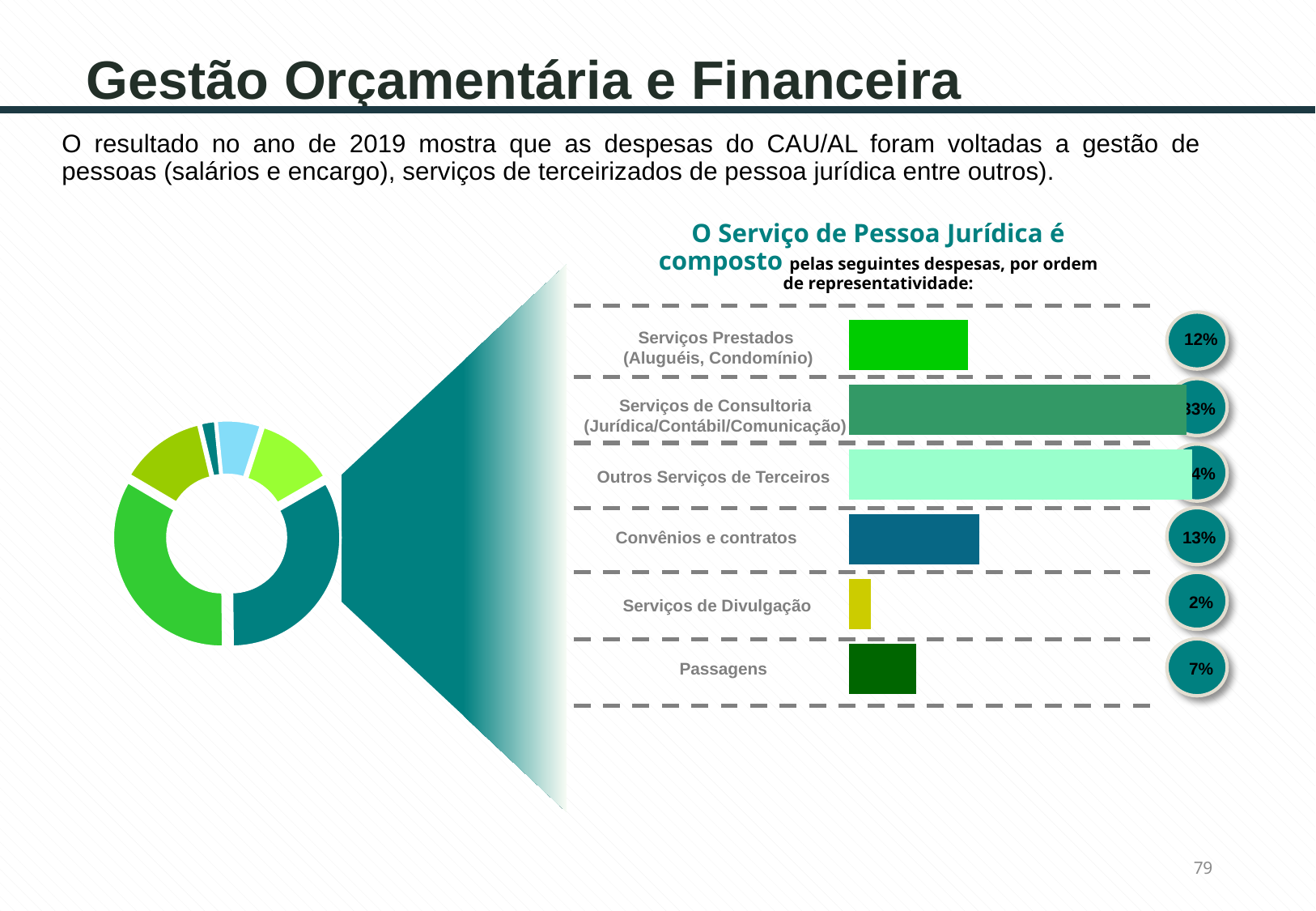
In the bar chart on the right, what percentage is shown for Serviços de Divulgação? 2% How many categories are shown in the bar chart on the right? 6 In the bar chart on the right, which is larger: Passagens or Serviços de Divulgação? Passagens In the bar chart on the right, which category has the lowest percentage? Serviços de Divulgação What kind of chart is the chart on the right of the slide? Bar chart In the bar chart on the right, what percentage is shown for Convênios e contratos? 13% In the bar chart on the right, what percentage is shown for Serviços Prestados (Aluguéis, Condomínio)? 12% In the bar chart on the right, what is the difference in percentage points between Serviços Prestados (Aluguéis, Condomínio) and Passagens? 5% What kind of chart is the chart on the left of the slide? Donut chart In the bar chart on the right, what percentage is shown for Passagens? 7% In the bar chart on the right, what is the difference in percentage points between Convênios e contratos and Serviços Prestados (Aluguéis, Condomínio)? 1% In the bar chart on the right, which is larger: Serviços de Consultoria (Jurídica/Contábil/Comunicação) or Convênios e contratos? Serviços de Consultoria (Jurídica/Contábil/Comunicação)